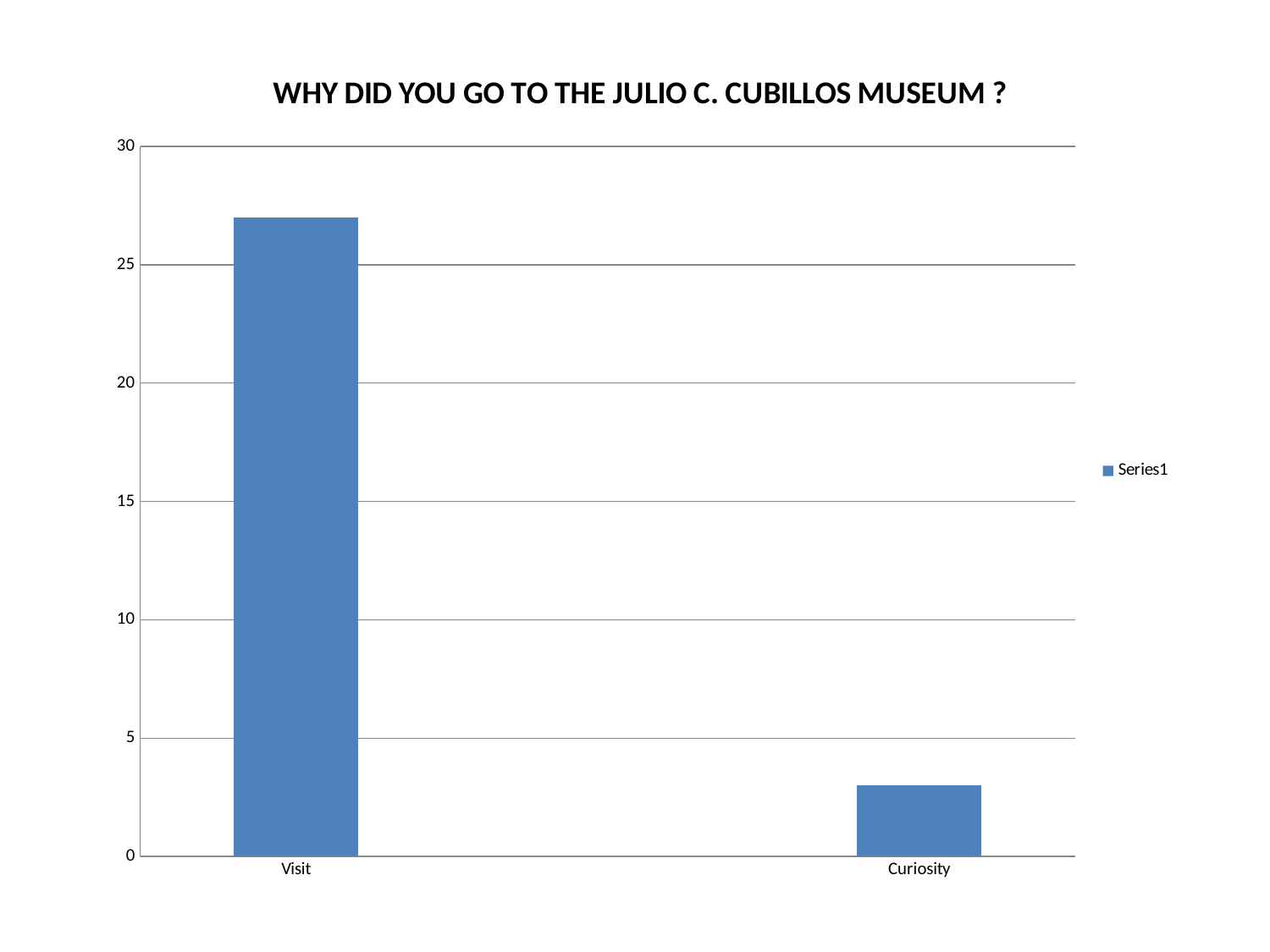
Is the value for Curiosity greater or less than 5? less What kind of chart is shown on the slide? bar chart Is the value for Visit greater or less than 30? less How many categories are shown on the x axis? 2 How many series does the legend list? 1 What is the title of the chart? WHY DID YOU GO TO THE JULIO C. CUBILLOS MUSEUM ? Do the values rise or fall from Visit to Curiosity along the x axis? fall Which category has the lowest value? Curiosity Which category has the highest value? Visit Is the value for Visit greater or less than 25? greater What is the name of the series in the legend? Series1 Which is larger, the value for Visit or the value for Curiosity? Visit